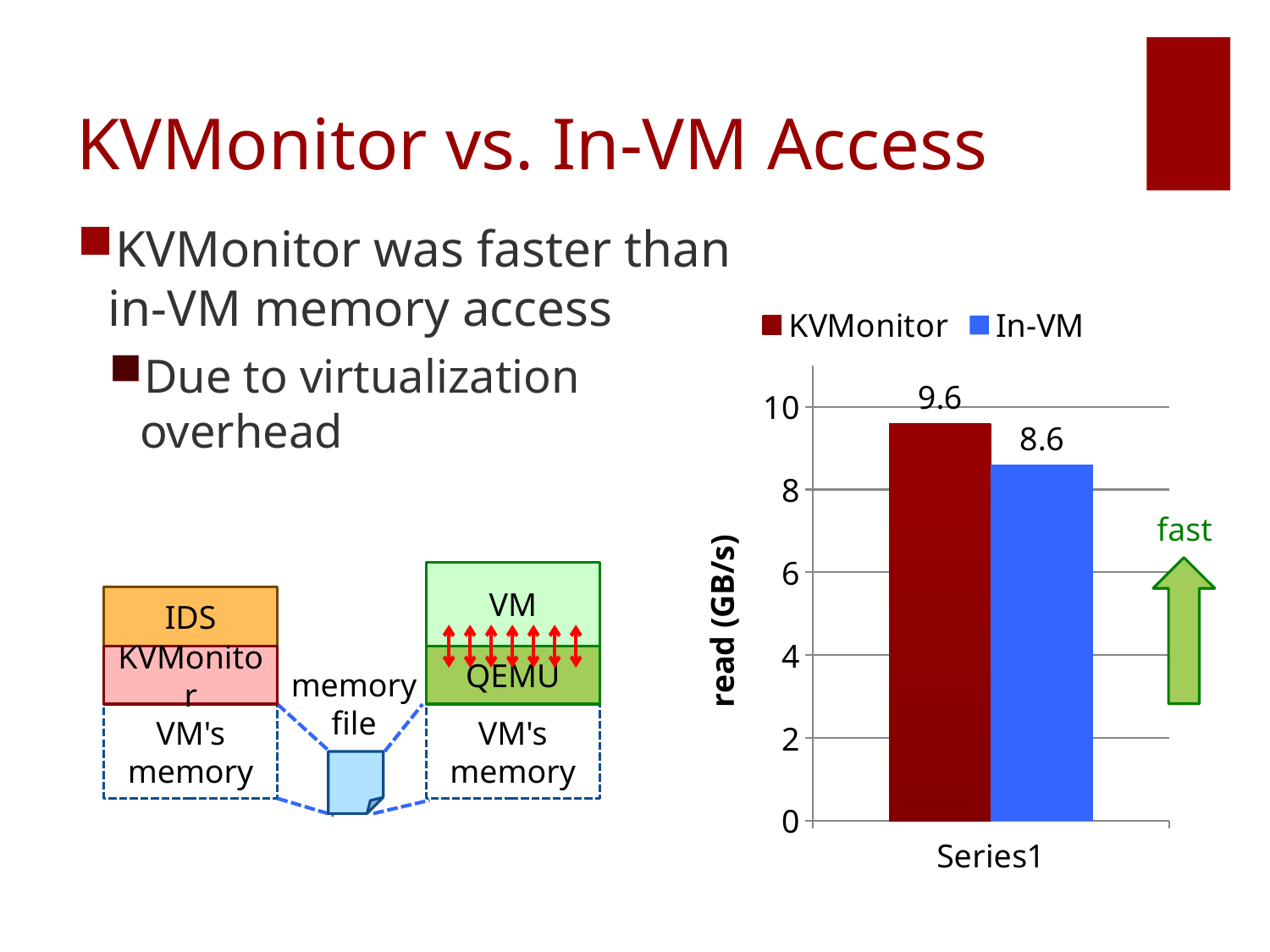
What is the read value for KVMonitor? 9.6 Which series has the higher read value, KVMonitor or In-VM? KVMonitor Is the value for In-VM greater or less than 8? greater What is the difference between the KVMonitor and In-VM read values? 1.0 Which series has the lowest read value? In-VM How many bars are plotted in the chart? 2 What colour is the In-VM bar? blue What is the read value for In-VM? 8.6 Is the value for KVMonitor greater or less than 10? less What is the label of the y axis? read (GB/s) What kind of chart is shown on the slide? bar chart How many series does the legend list? 2